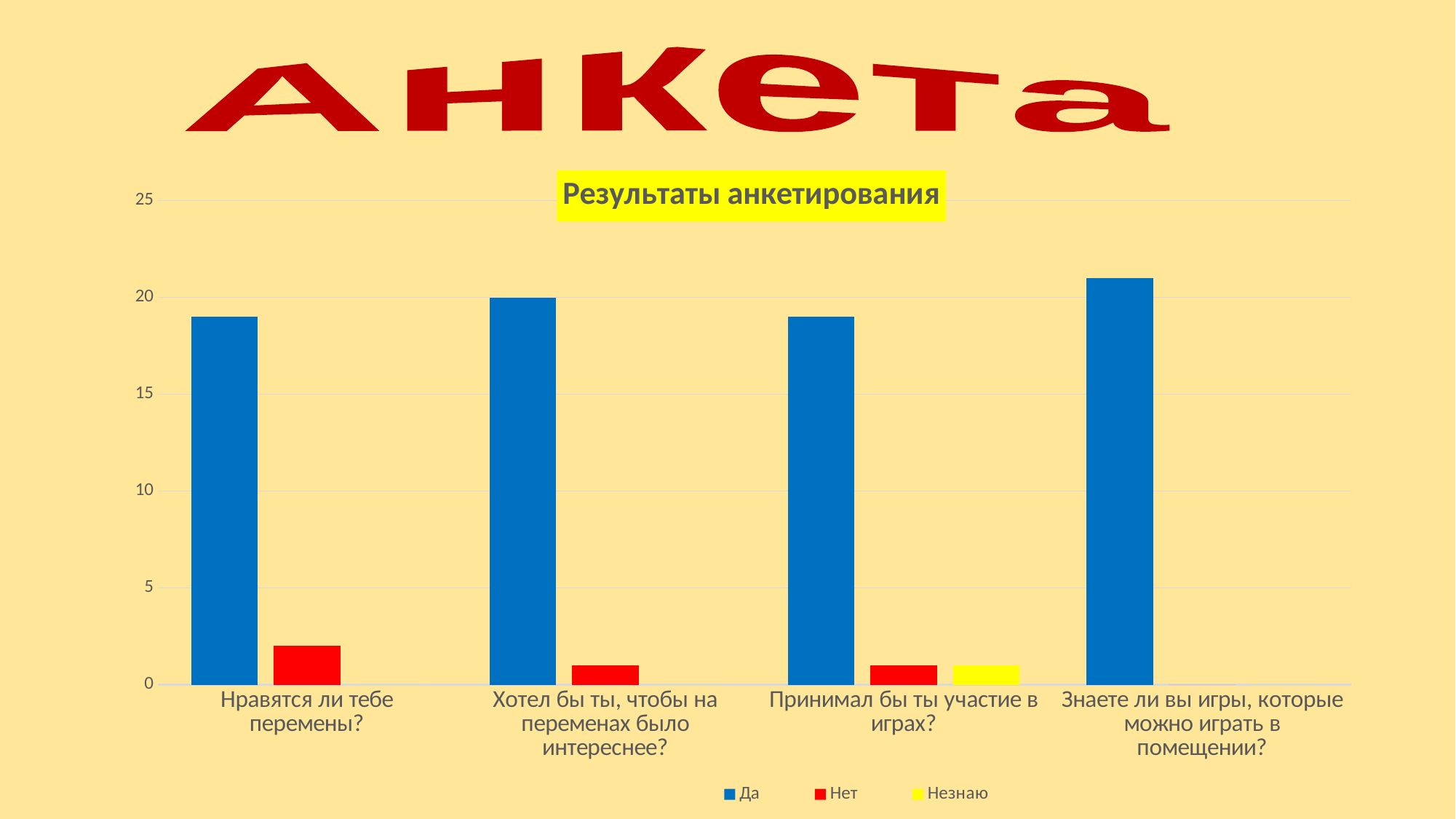
Which question is the only one with a visible Незнаю bar? Принимал бы ты участие в играх? Which series is shown in yellow in the legend? Незнаю What is the title of the chart? Результаты анкетирования Is the Да value for "Принимал бы ты участие в играх?" greater or less than 10? greater Which has the larger Нет value: "Нравятся ли тебе перемены?" or "Хотел бы ты, чтобы на переменах было интереснее?" Нравятся ли тебе перемены? Is the Нет value for "Нравятся ли тебе перемены?" greater or less than 5? less Which question has the highest value for the Да series? Знаете ли вы игры, которые можно играть в помещении? For "Хотел бы ты, чтобы на переменах было интереснее?", which is larger: the Да value or the Нет value? Да Is the Да value for "Нравятся ли тебе перемены?" greater or less than 15? greater What kind of chart is shown on the slide? bar chart How many questions (categories) are shown along the x axis? 4 How many series does the legend list? 3